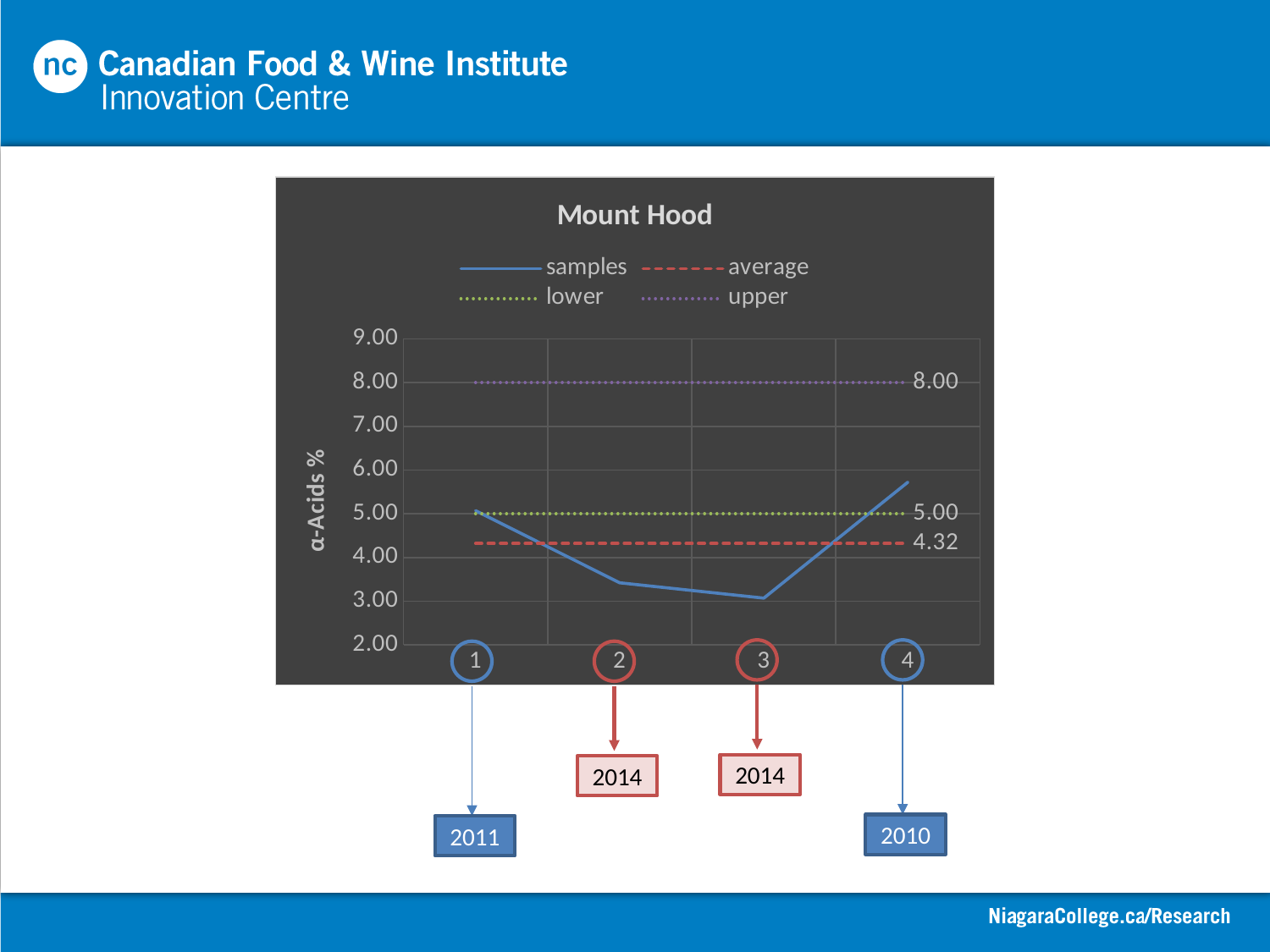
How many sample points are plotted along the x axis? 4 At which x-axis point is the samples line lowest? 3 What is the y-axis title of the chart? α-Acids % What is the difference between the upper value and the lower value? 3.00 What value is labelled for the average line? 4.32 What is the title of the chart? Mount Hood Is the samples value at point 3 greater or less than 4.00? less Is the samples value at point 4 greater or less than 5.00? greater What kind of chart is shown on the slide? line chart What value is labelled for the lower line? 5.00 How many series does the legend list? 4 What value is labelled for the upper line? 8.00